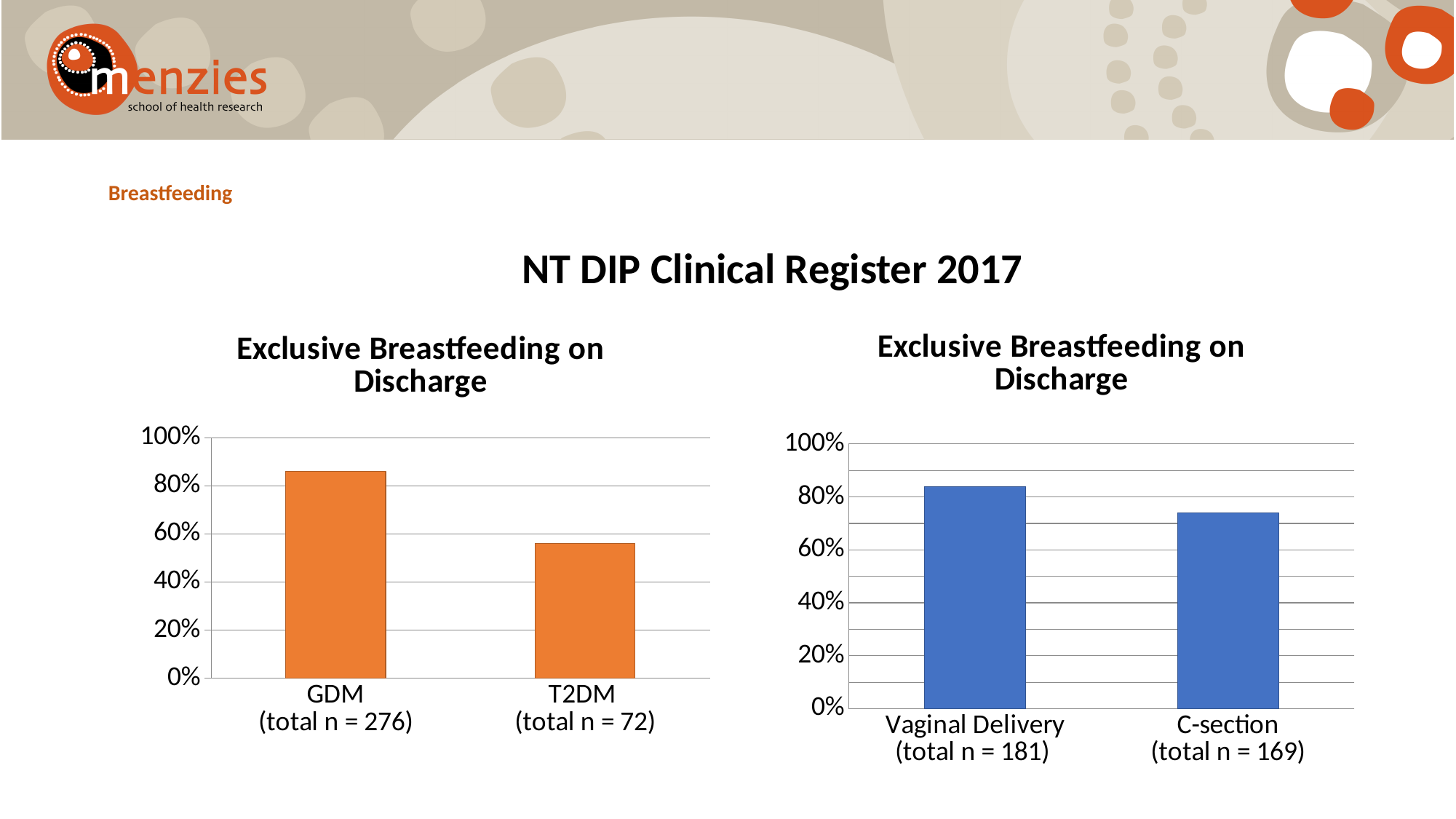
What colour are the bars on the left chart? Orange What kind of chart is the left chart? Bar chart On the right chart, is the value for Vaginal Delivery greater or less than 80%? greater On the left chart, is the value for T2DM greater or less than 60%? less On the right chart, is the value for C-section greater or less than 80%? less On the left chart, which category has the lowest value? T2DM On the right chart, which category has the higher value, Vaginal Delivery or C-section? Vaginal Delivery What is the total n for the C-section group on the right chart? 169 How many categories are shown on the left chart? 2 On the left chart, which category has the higher exclusive breastfeeding rate, GDM or T2DM? GDM